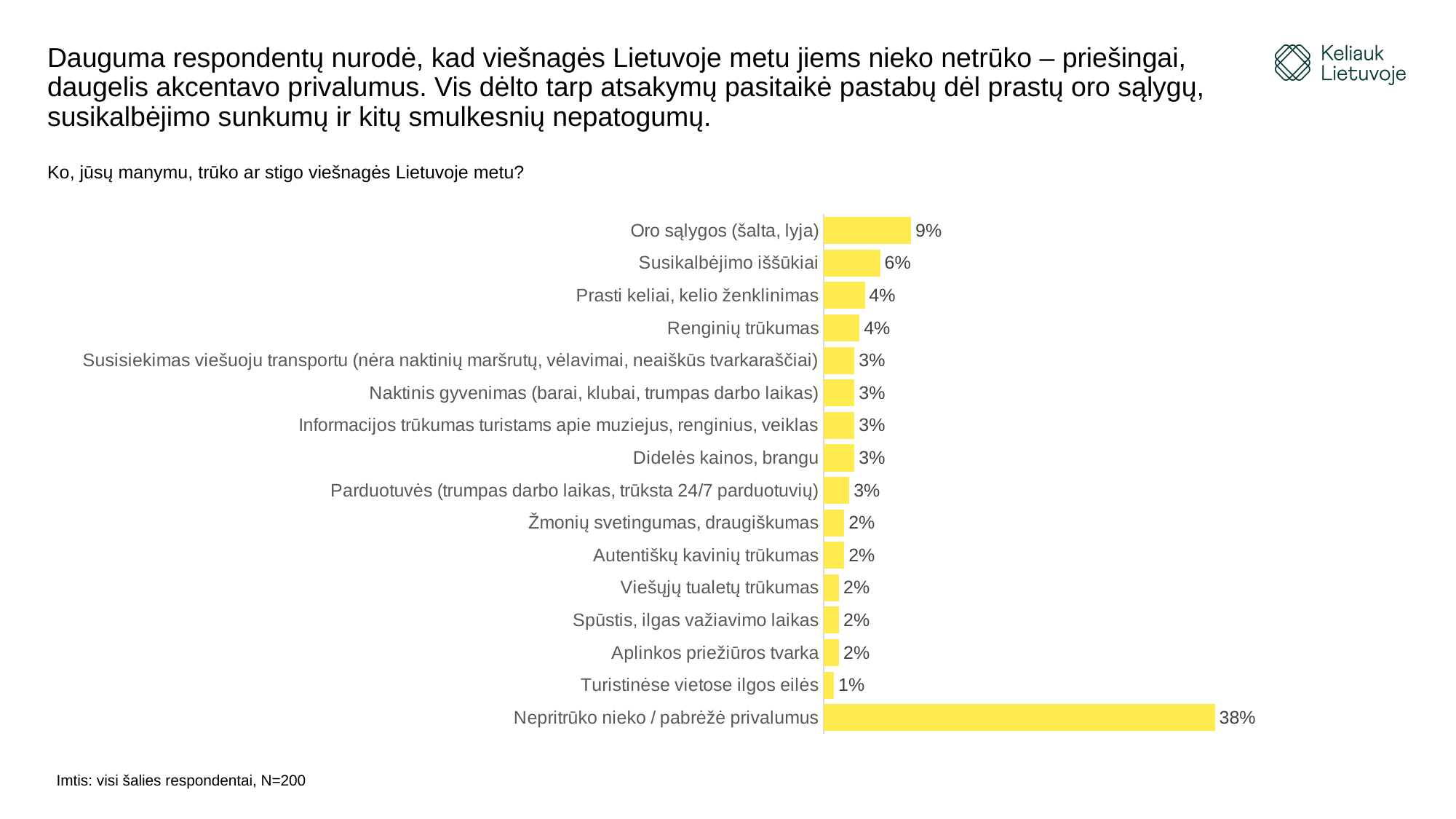
How many categories are shown in the chart? 16 What kind of chart is shown on the slide? Bar chart What is the value for 'Oro sąlygos (šalta, lyja)'? 9% What sample size is stated below the chart? N=200 What is the value for 'Turistinėse vietose ilgos eilės'? 1% Which category has the highest value in the chart? Nepritrūko nieko / pabrėžė privalumus What percentage of respondents said nothing was lacking / emphasised advantages (Nepritrūko nieko / pabrėžė privalumus)? 38% Which category has the lowest value in the chart? Turistinėse vietose ilgos eilės Which is larger: the value for 'Prasti keliai, kelio ženklinimas' or the value for 'Didelės kainos, brangu'? Prasti keliai, kelio ženklinimas What is the value for 'Aplinkos priežiūros tvarka'? 2% What is the value for 'Susikalbėjimo iššūkiai'? 6% What is the difference between the values for 'Oro sąlygos (šalta, lyja)' and 'Susikalbėjimo iššūkiai'? 3%